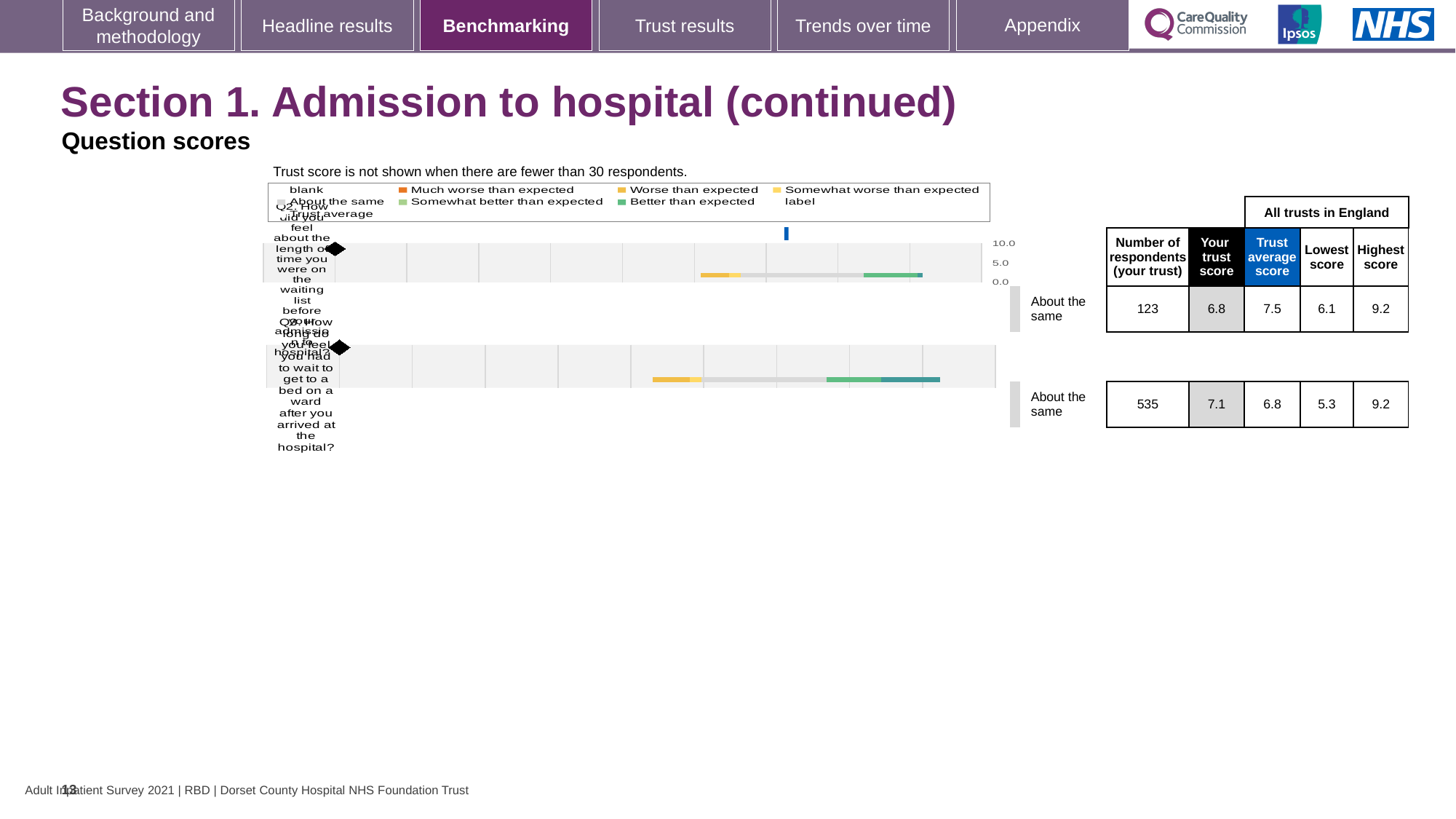
What kind of chart is used to show the question scores? Bar chart What is the trust score for Q3 (wait to get to a bed on a ward after arriving at the hospital)? 7.1 What is the trust score for Q2 (length of time on the waiting list before admission)? 6.8 What is the trust average score across all trusts in England for Q2? 7.5 What is the highest score across all trusts in England for Q2? 9.2 How many respondents answered Q3 at this trust? 535 What is the lowest score across all trusts in England for Q3? 5.3 What benchmark category is shown for Q3 on the chart? About the same What is the difference between the trust average score and this trust's score for Q2? 0.7 How many respondents answered Q2 at this trust? 123 Which question has the higher trust score for this trust, Q2 or Q3? Q3 How many questions are plotted on the chart? 2